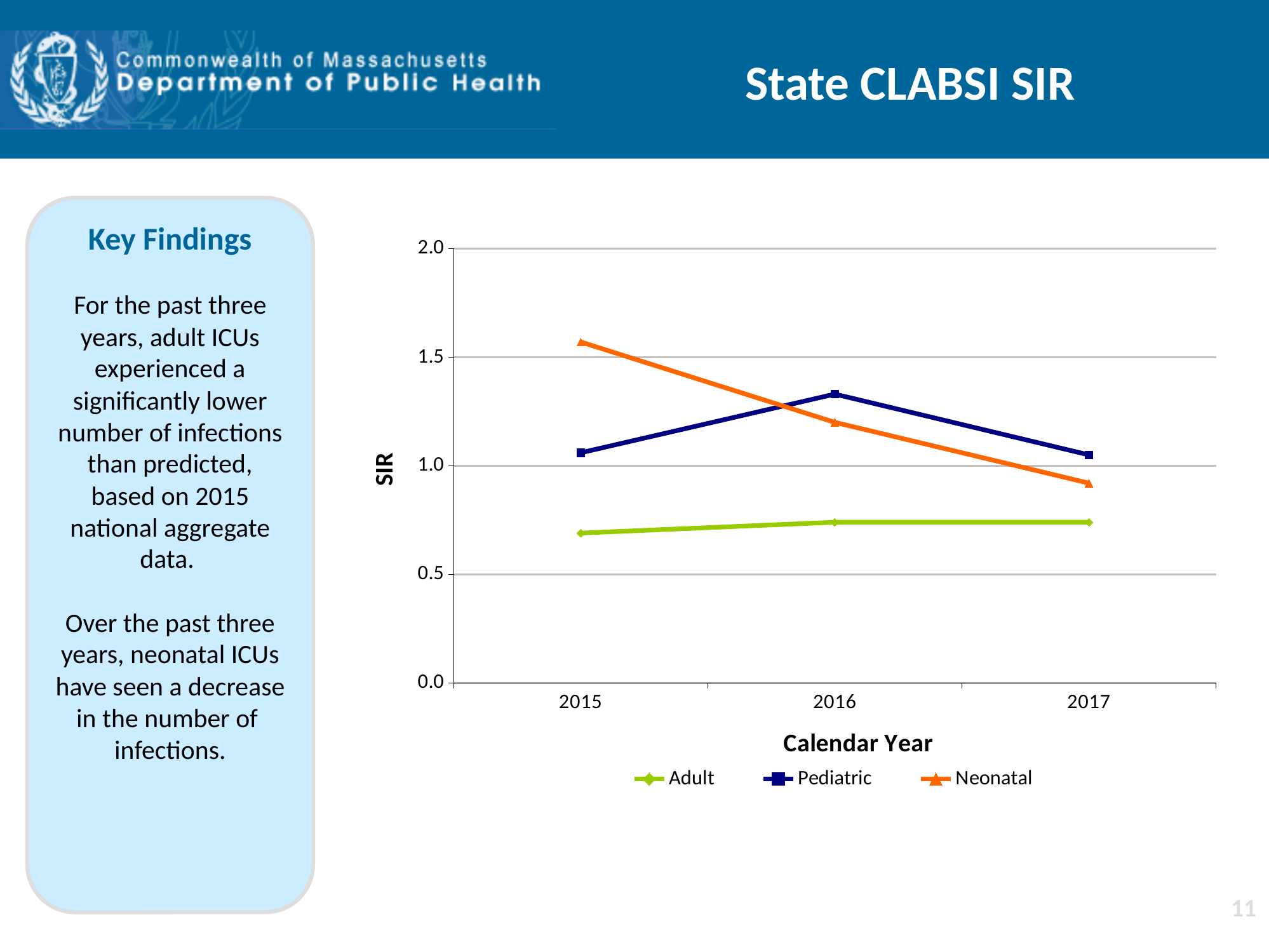
Which series has the highest SIR in 2015? Neonatal Which is larger in 2017, the Pediatric SIR or the Neonatal SIR? Pediatric How many calendar years are plotted on the x axis? 3 Is the Neonatal SIR value for 2017 greater or less than 1.0? less What kind of chart is shown on the slide? line chart What is the title of the x axis of the chart? Calendar Year Is the Neonatal SIR value for 2015 greater or less than 1.5? greater Is the Adult SIR value for 2015 greater or less than 1.0? less Which series has the highest SIR in 2016? Pediatric Which series has the lowest SIR in 2017? Adult Does the Neonatal SIR rise or fall from 2015 to 2017? fall How many series does the chart legend list? 3